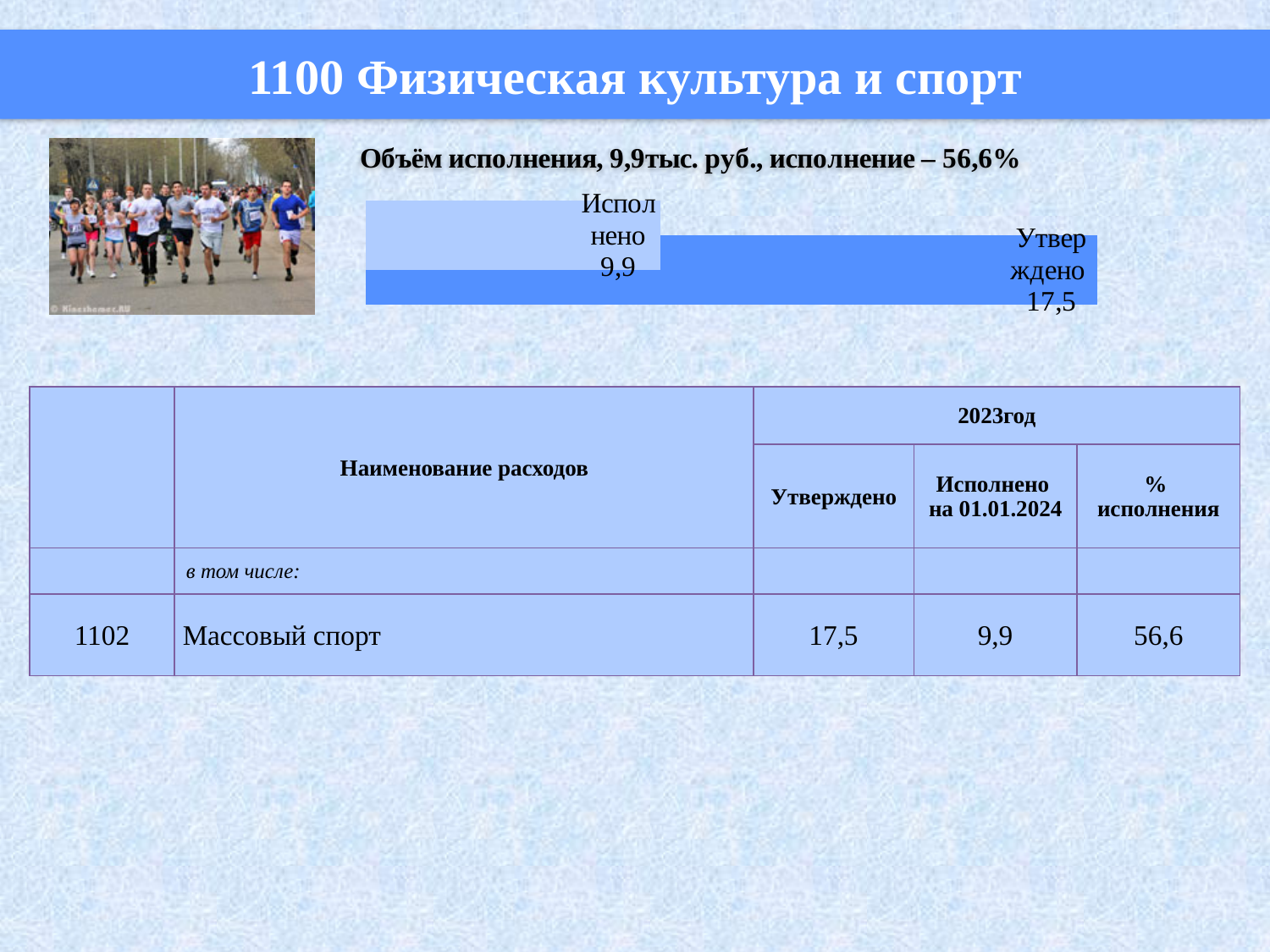
Is the value for Исполнено larger or smaller than the value for Утверждено? smaller What kind of chart is shown on the slide? bar chart Which bar in the chart is drawn in the darker blue colour? Утверждено What value is shown for the bar labelled Исполнено? 9,9 How many bars are plotted in the chart? 2 What is the difference between the Утверждено value and the Исполнено value? 7,6 Which bar has the higher value, Исполнено or Утверждено? Утверждено Are the bars in the chart oriented horizontally or vertically? horizontally What value is shown for the bar labelled Утверждено? 17,5 Which bar has the lowest value in the chart? Исполнено